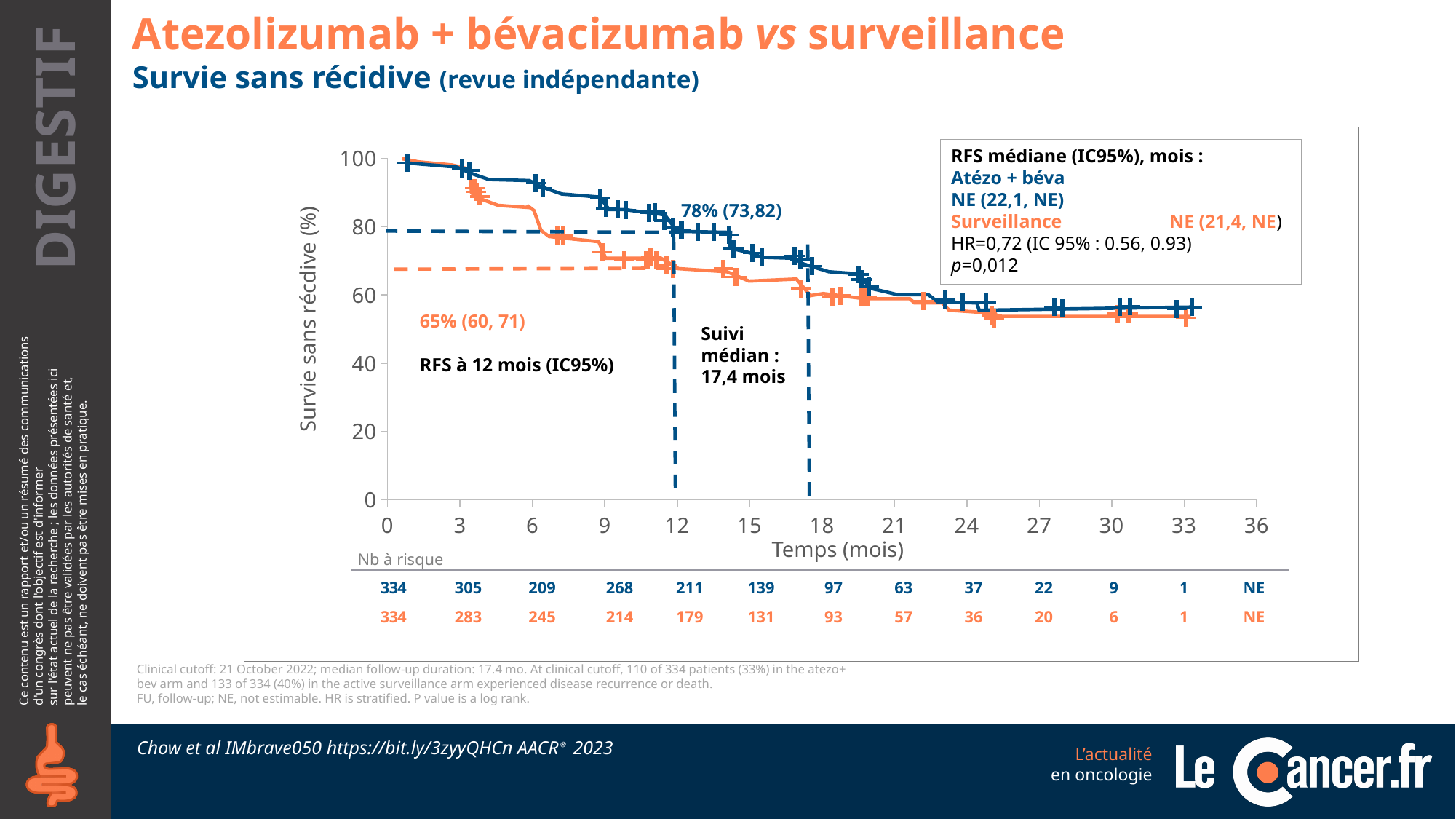
What kind of chart is shown on the slide? Line chart (Kaplan-Meier survival curve) What is the hazard ratio reported in the chart's text box? HR=0,72 (IC 95% : 0.56, 0.93) What is the recurrence-free survival rate at 12 months for the Surveillance arm? 65% (60, 71) What is the difference in 12-month RFS between the Atézo + béva arm and the Surveillance arm? 13 percentage points Do the survival curves rise or fall as time (months) increases? Fall Is the value of the Atézo + béva curve at 18 months greater or less than 80? less What is the median follow-up shown on the chart? 17,4 mois How many treatment arms (curves) are plotted on the chart? 2 Which arm has the higher RFS at 12 months? Atézo + béva What is the recurrence-free survival rate at 12 months for the Atézo + béva arm? 78% (73,82) How many patients were at risk in the Atézo + béva arm at 12 months? 211 How many patients were at risk in the Surveillance arm at 12 months? 179